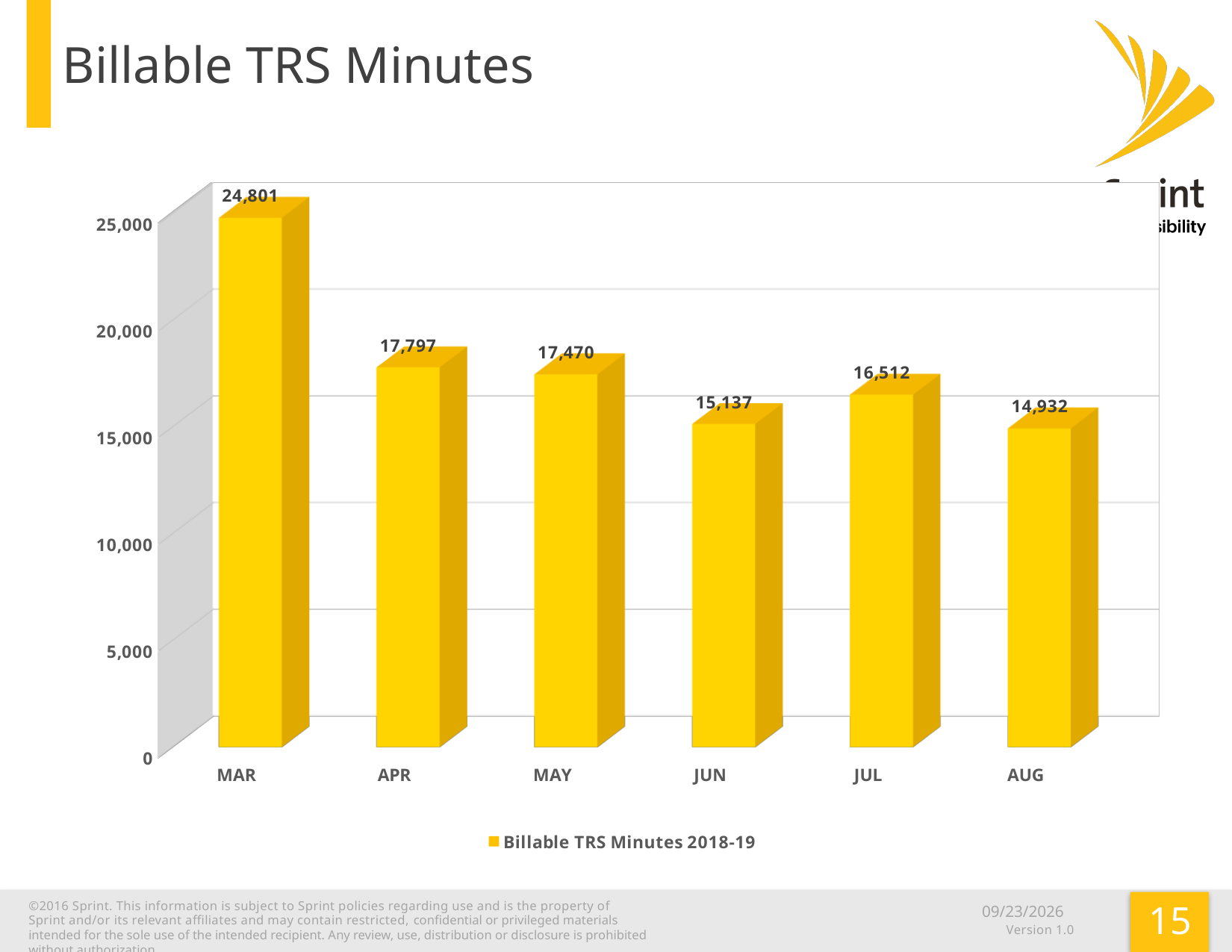
How many months are shown on the x axis? 6 What is the value for AUG? 14,932 Which month has the highest billable TRS minutes? MAR What is the difference between the values for JUL and JUN? 1,375 What kind of chart is shown on the slide? bar chart Is the value for JUL greater or less than 15,000? greater What is the legend entry for the series shown? Billable TRS Minutes 2018-19 Which month has the lowest billable TRS minutes? AUG What is the difference between the values for MAR and APR? 7,004 What is the value for JUN? 15,137 What is the value for MAR? 24,801 Which is larger, the value for APR or the value for MAY? APR